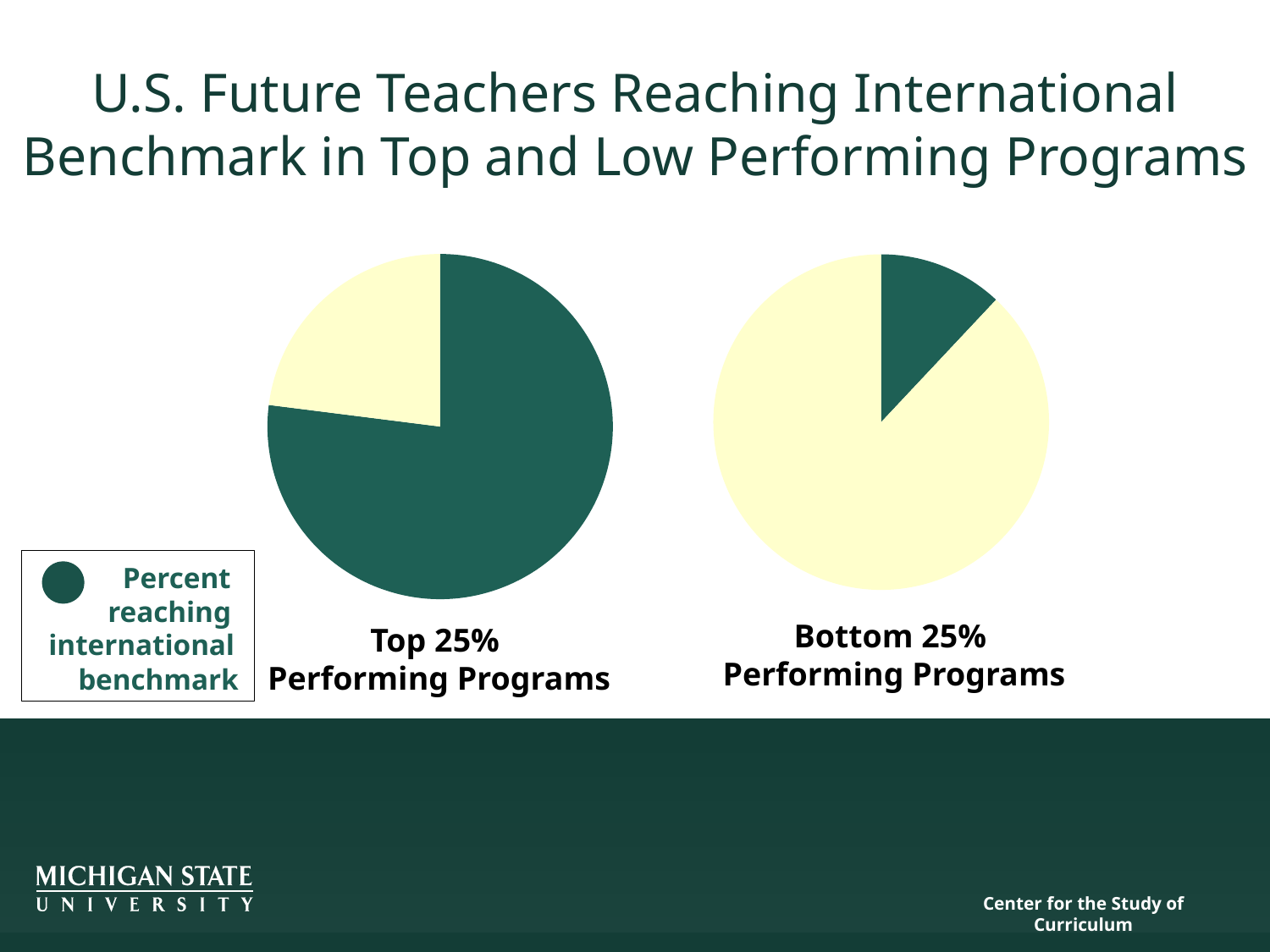
How many pie charts are shown on the slide? 2 According to the legend, what does the dark green slice represent? Percent reaching international benchmark What kind of chart is used for the Top 25% Performing Programs? pie chart Which pie chart has the larger dark green slice, Top 25% Performing Programs or Bottom 25% Performing Programs? Top 25% Performing Programs In the Bottom 25% Performing Programs pie chart, how many slices are there? 2 What kind of chart is used for the Bottom 25% Performing Programs? pie chart Which pie chart has the smaller share of future teachers reaching the international benchmark, Top 25% Performing Programs or Bottom 25% Performing Programs? Bottom 25% Performing Programs What is the title of the slide containing the two pie charts? U.S. Future Teachers Reaching International Benchmark in Top and Low Performing Programs In the Top 25% Performing Programs pie chart, how many slices are there? 2 In the Top 25% Performing Programs pie chart, which slice is larger, the dark green slice or the pale yellow slice? dark green